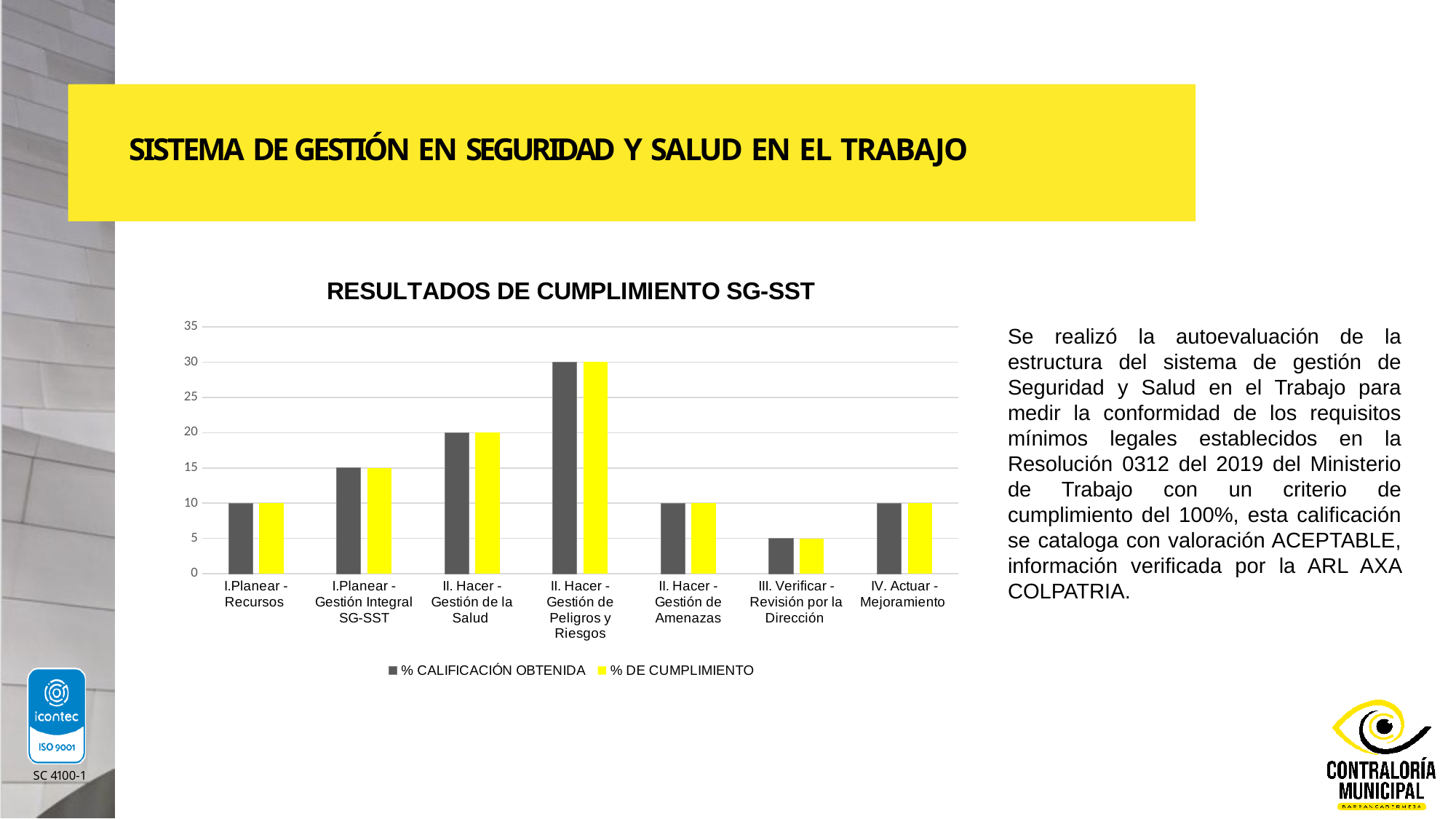
What is the % CALIFICACIÓN OBTENIDA value for III. Verificar - Revisión por la Dirección? 5 Which category has the highest % CALIFICACIÓN OBTENIDA value? II. Hacer - Gestión de Peligros y Riesgos How many series does the chart legend list? 2 Which is larger: the % CALIFICACIÓN OBTENIDA value for I.Planear - Gestión Integral SG-SST or for IV. Actuar - Mejoramiento? I.Planear - Gestión Integral SG-SST What is the % CALIFICACIÓN OBTENIDA value for II. Hacer - Gestión de Peligros y Riesgos? 30 How many categories are shown on the x axis of the chart? 7 What is the difference between the % CALIFICACIÓN OBTENIDA values for II. Hacer - Gestión de Peligros y Riesgos and II. Hacer - Gestión de la Salud? 10 Is the % DE CUMPLIMIENTO value for II. Hacer - Gestión de la Salud greater or less than 25? less What is the title of the chart? RESULTADOS DE CUMPLIMIENTO SG-SST What kind of chart is shown on the slide? bar chart Which category has the lowest % DE CUMPLIMIENTO value? III. Verificar - Revisión por la Dirección What is the % DE CUMPLIMIENTO value for I.Planear - Gestión Integral SG-SST? 15